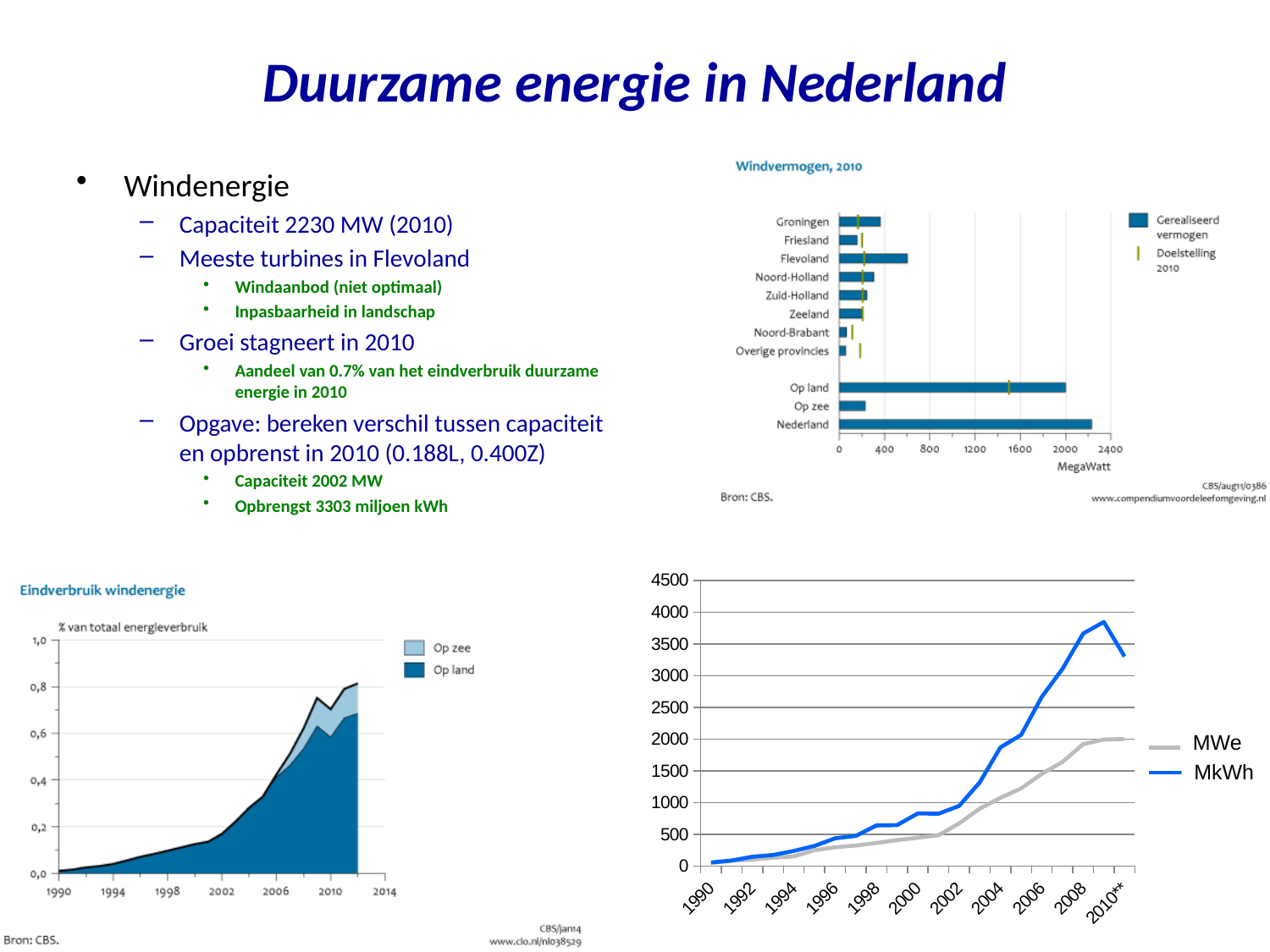
In the bottom-right line chart, is the MkWh value for 2010** greater or less than 3000? greater What kind of chart is the 'Windvermogen, 2010' chart? Bar chart In the bottom-right line chart, is the MWe value for 2010** greater or less than 2500? less In the 'Windvermogen, 2010' chart, is the realised capacity for Op zee greater or less than 400 MegaWatt? less What are the two legend entries of the 'Eindverbruik windenergie' chart? Op zee and Op land In the 'Windvermogen, 2010' chart, which has the larger realised capacity, Op land or Op zee? Op land In the 'Windvermogen, 2010' chart, which province has the highest realised capacity? Flevoland How many series does the legend of the bottom-right line chart list? 2 In the bottom-right line chart, does the MWe series generally rise or fall from 1990 to 2010**? Rise In the 'Windvermogen, 2010' chart, which has the larger realised capacity, Groningen or Friesland? Groningen